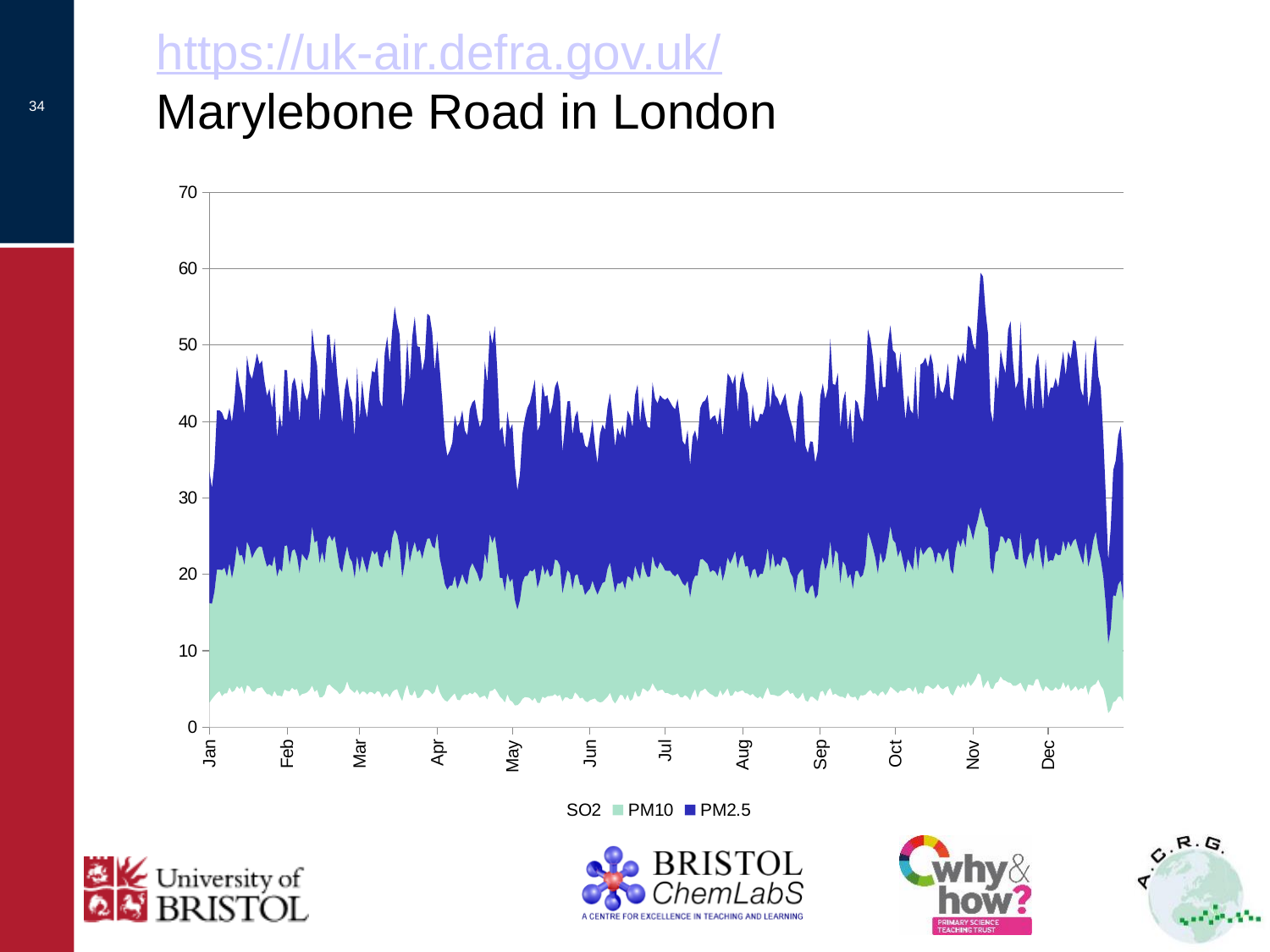
Is the stacked total in July greater or less than 30? greater Is the lowest dip of the stacked total, at the end of December, greater or less than 20? greater Is the highest peak of the stacked total, around November, greater or less than 50? greater Which series is shown in dark blue? PM2.5 How many series does the legend list? 3 What is the highest value shown on the y axis? 70 In which month does the stacked total reach its highest peak? Nov Which series is plotted at the bottom of the stack? SO2 How many months are labelled along the x axis? 12 Which month label appears first on the x axis? Jan What kind of chart is shown on the slide? Stacked area chart